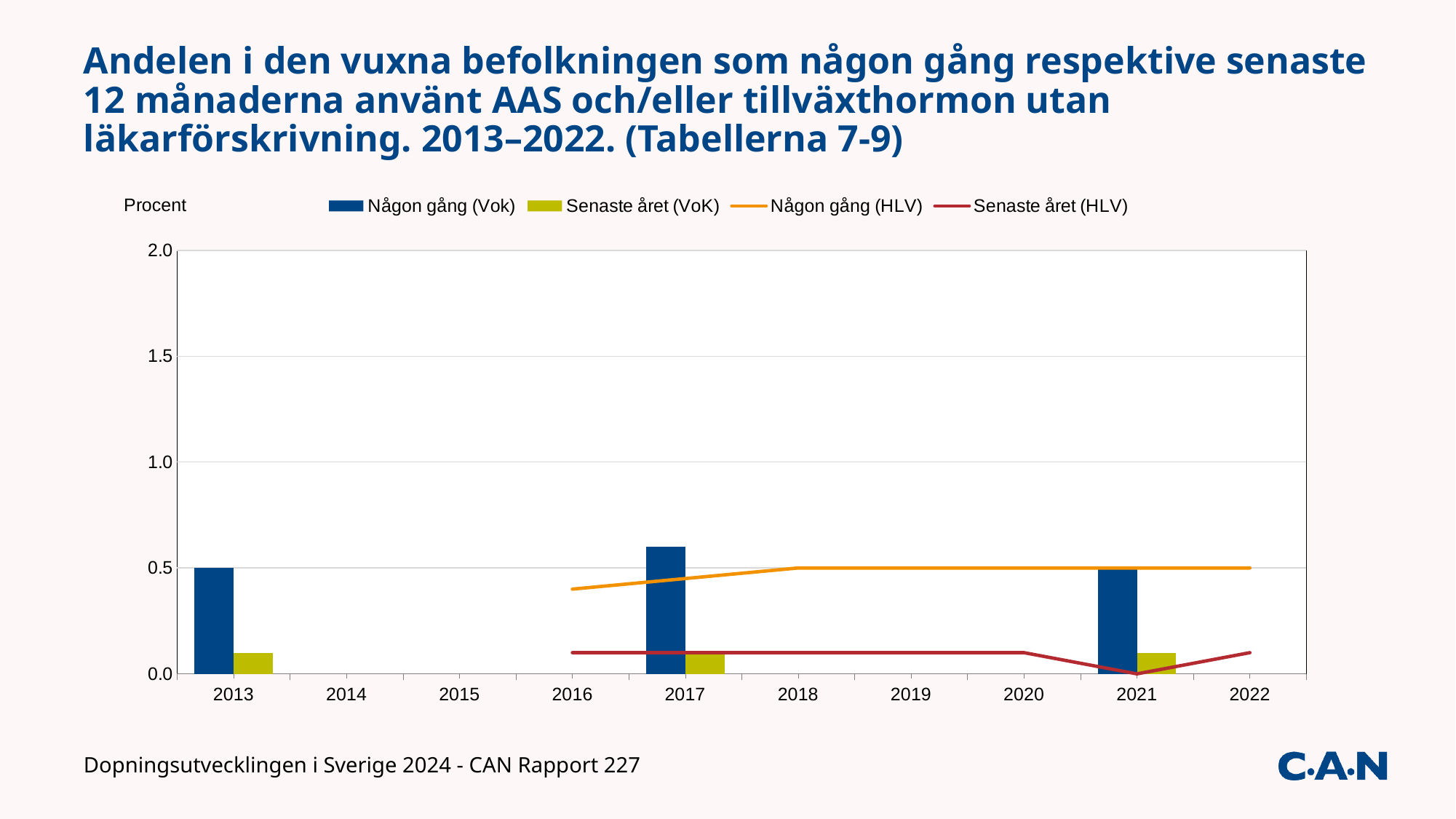
How many years are shown on the x axis? 10 Is the value for Någon gång (HLV) in 2016 greater or less than 0.5? less What is the value of Någon gång (Vok) in 2013? 0.5 In which year is the Någon gång (Vok) bar highest? 2017 Is the value for Någon gång (Vok) in 2017 greater or less than 0.5? greater What is the value of the Någon gång (HLV) line in 2020? 0.5 How many series does the legend list? 4 What is the value of the Senaste året (HLV) line in 2021? 0.0 What colour are the Någon gång (Vok) bars? Dark blue What is the value of Någon gång (Vok) in 2021? 0.5 What kind of chart is shown on the slide? A combined bar and line chart Which is larger: Någon gång (Vok) in 2017 or Någon gång (Vok) in 2013? 2017